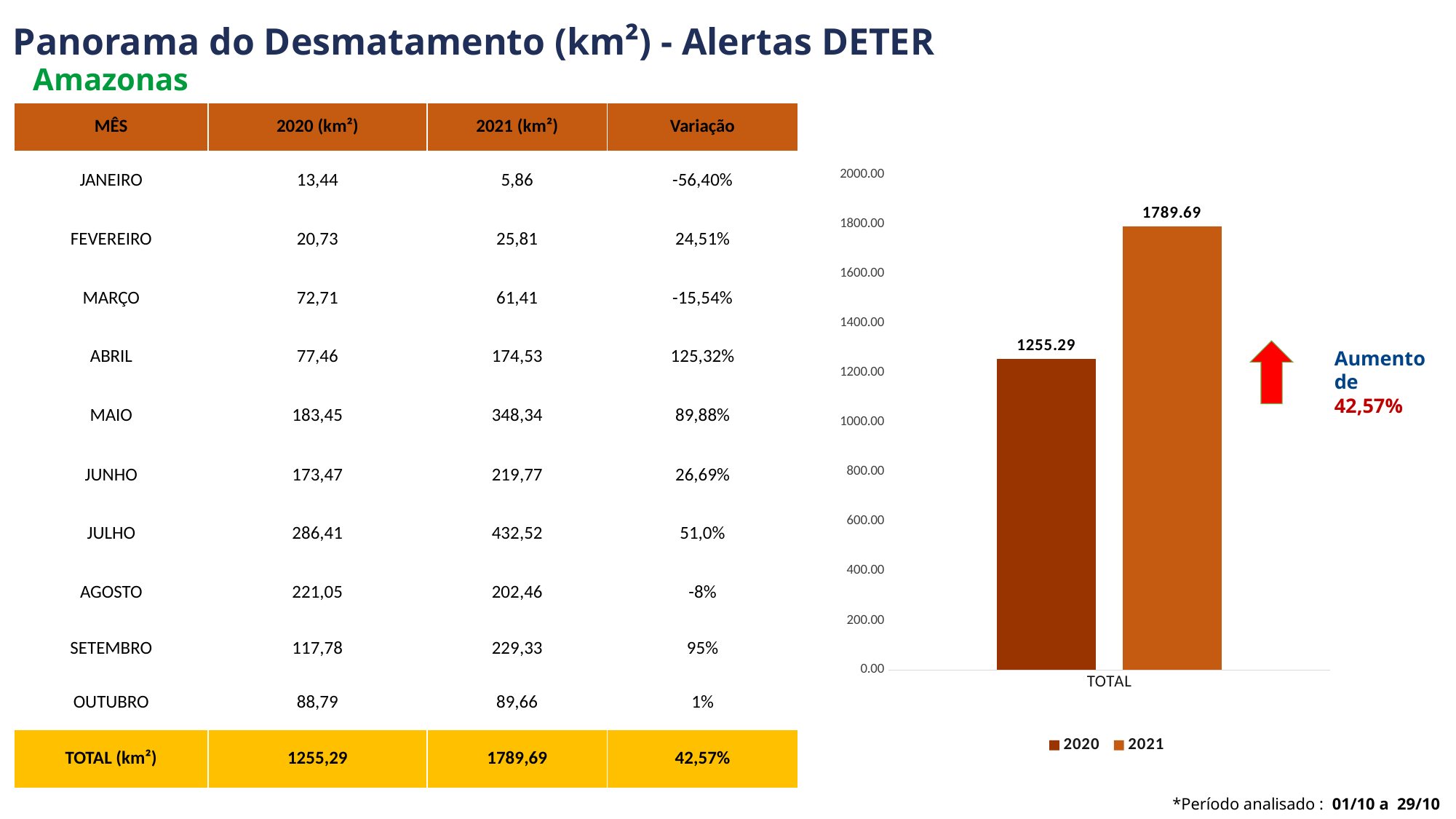
How many series does the chart legend list? 2 How many categories are shown on the x axis of the chart? 1 What is the label of the category on the x axis of the chart? TOTAL What type of chart is shown on the slide? bar chart Which series has the higher bar in the chart, 2020 or 2021? 2021 What is the value of the 2021 bar in the chart? 1789.69 Which series has the lowest value in the chart? 2020 Is the value for 2021 in the chart greater or less than 1600.00? greater Which series has the highest value in the chart? 2021 What is the difference between the 2021 and 2020 values in the chart? 534.40 What is the value of the 2020 bar in the chart? 1255.29 Is the value for 2020 in the chart greater or less than 1400.00? less